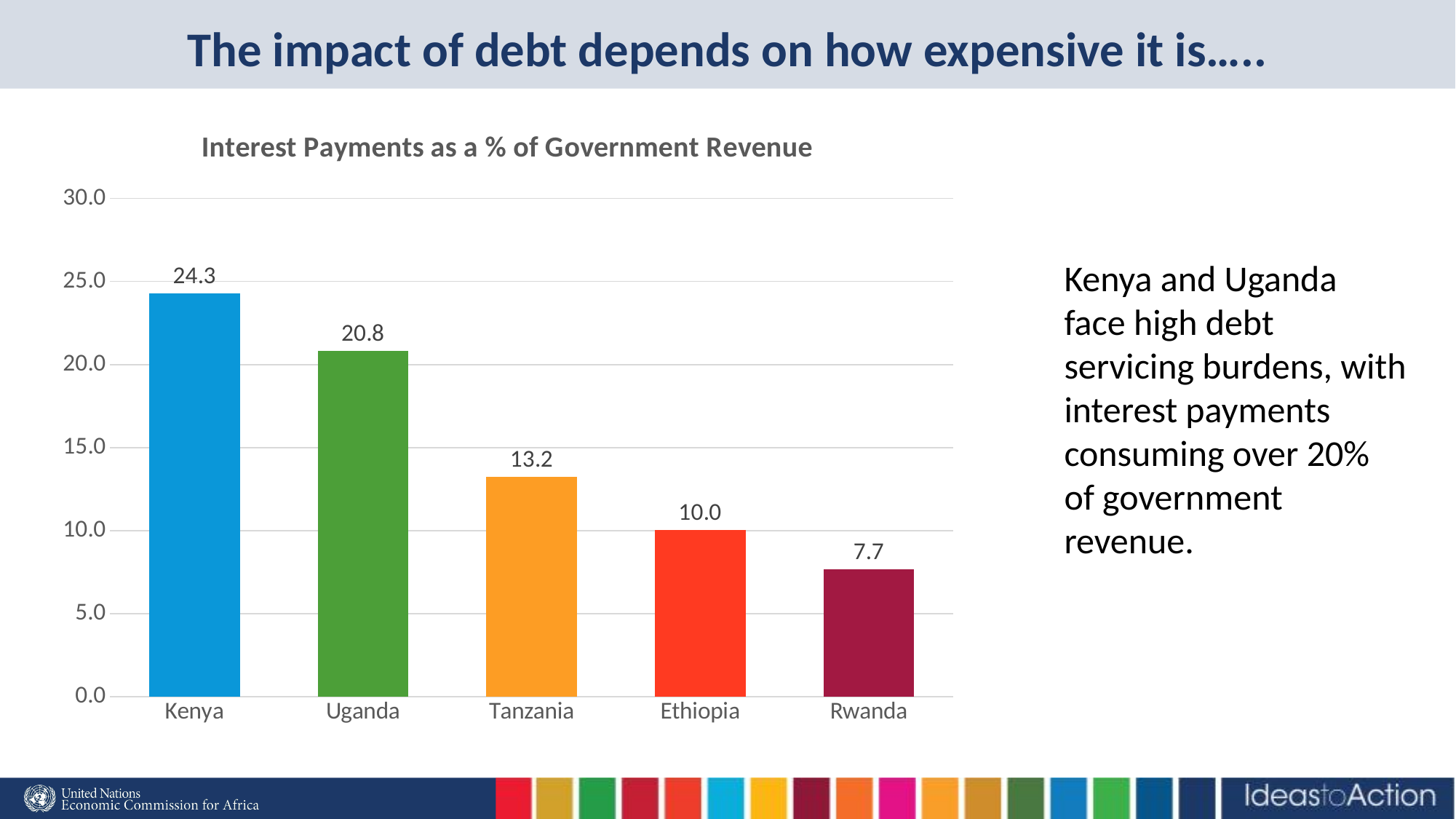
Is the value for Ethiopia greater or less than 15.0? less What is the difference between the values for Kenya and Uganda? 3.5 What is the value for Kenya? 24.3 What is the value for Rwanda? 7.7 What is the value for Tanzania? 13.2 What is the difference between the values for Ethiopia and Rwanda? 2.3 What is the title of the chart? Interest Payments as a % of Government Revenue Which country has the lowest interest payments as a % of government revenue? Rwanda What kind of chart is shown on the slide? bar chart How many countries are shown in the chart? 5 Which country has the highest interest payments as a % of government revenue? Kenya Which is larger, the value for Uganda or the value for Tanzania? Uganda